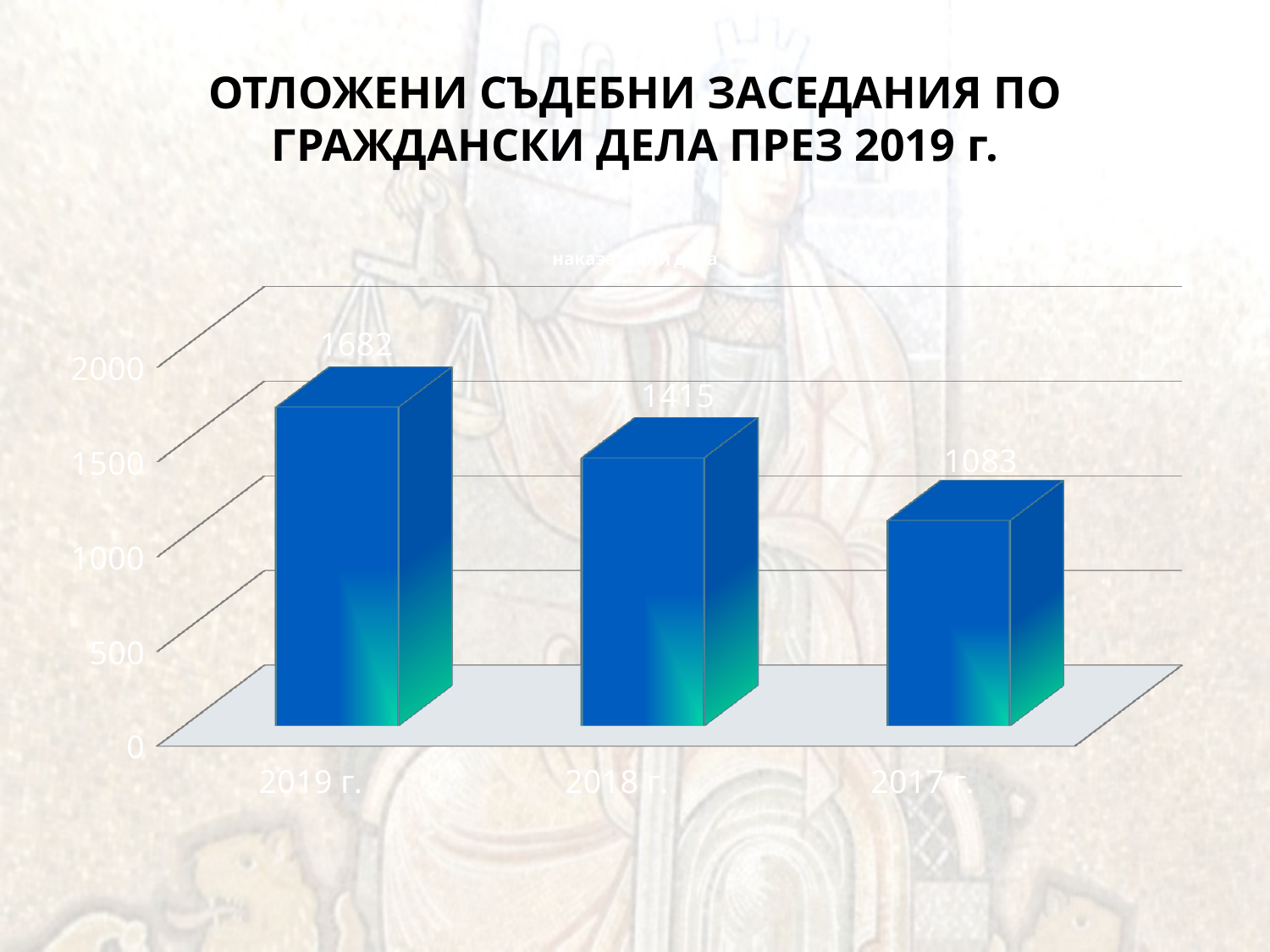
What is the value for 2018 г.? 1415 How many categories are shown on the x axis? 3 Do the values rise or fall moving from left to right along the x axis? fall Is the value for 2017 г. greater or less than 1500? less What kind of chart is shown on the slide? bar chart What is the difference between the values for 2019 г. and 2018 г.? 267 What is the value for 2019 г.? 1682 What is the difference between the values for 2018 г. and 2017 г.? 332 What is the value for 2017 г.? 1083 Which year has the lowest value? 2017 г. Which year has the highest value? 2019 г. Which is larger, the value for 2018 г. or the value for 2017 г.? 2018 г.